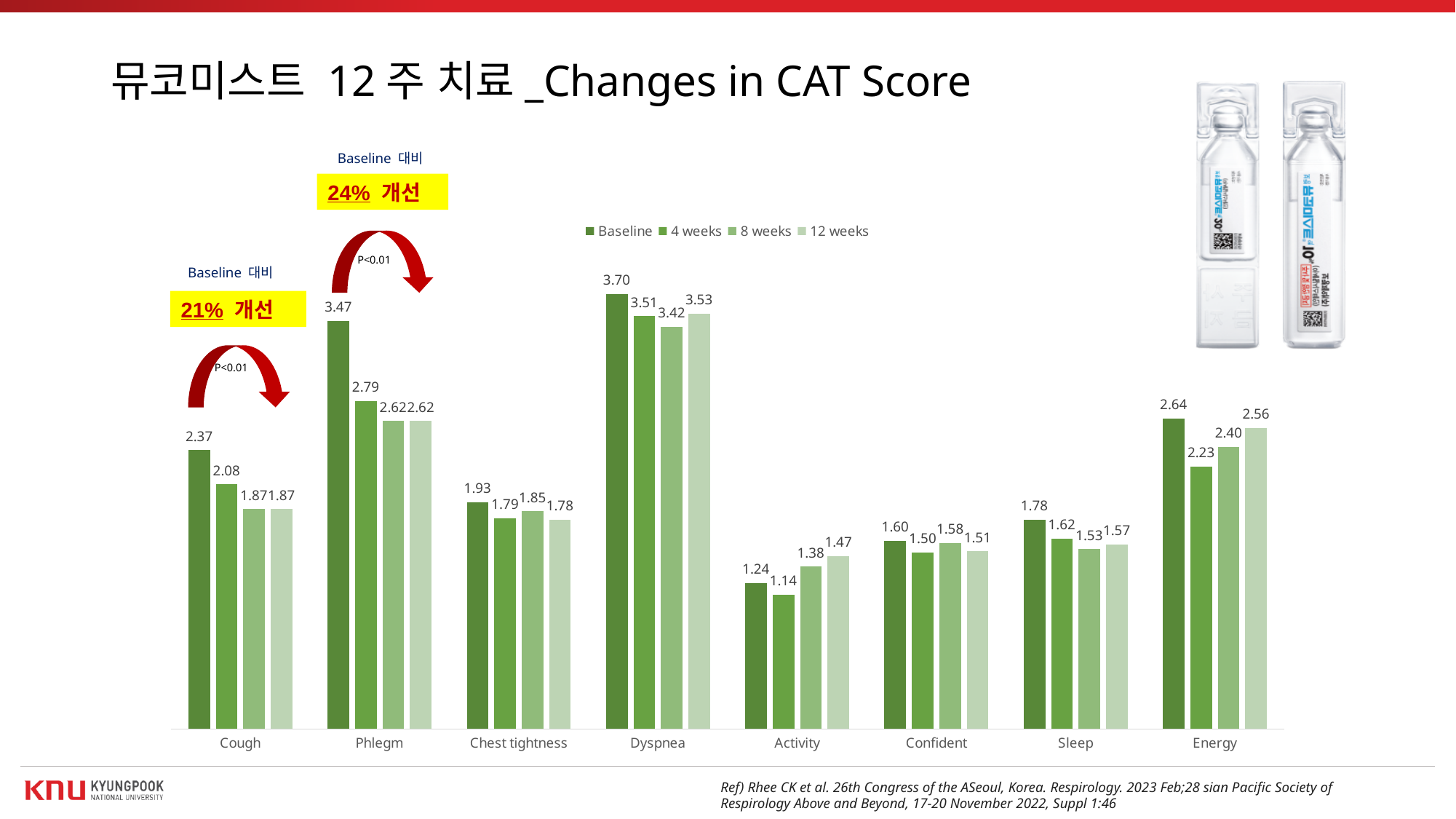
How many categories are shown on the x axis? 8 What is the difference between the Baseline and 12 weeks values for Cough? 0.50 Which category has the lowest Baseline value? Activity What is the 12 weeks value for Phlegm? 2.62 What is the 4 weeks value for Activity? 1.14 Which category has the highest Baseline value? Dyspnea What is the 8 weeks value for Energy? 2.40 How many series does the legend list? 4 What is the Baseline value for Cough? 2.37 Which is larger, the Baseline value for Sleep or the Baseline value for Energy? Energy What is the difference between the Baseline and 4 weeks values for Phlegm? 0.68 What kind of chart is shown on the slide? Bar chart